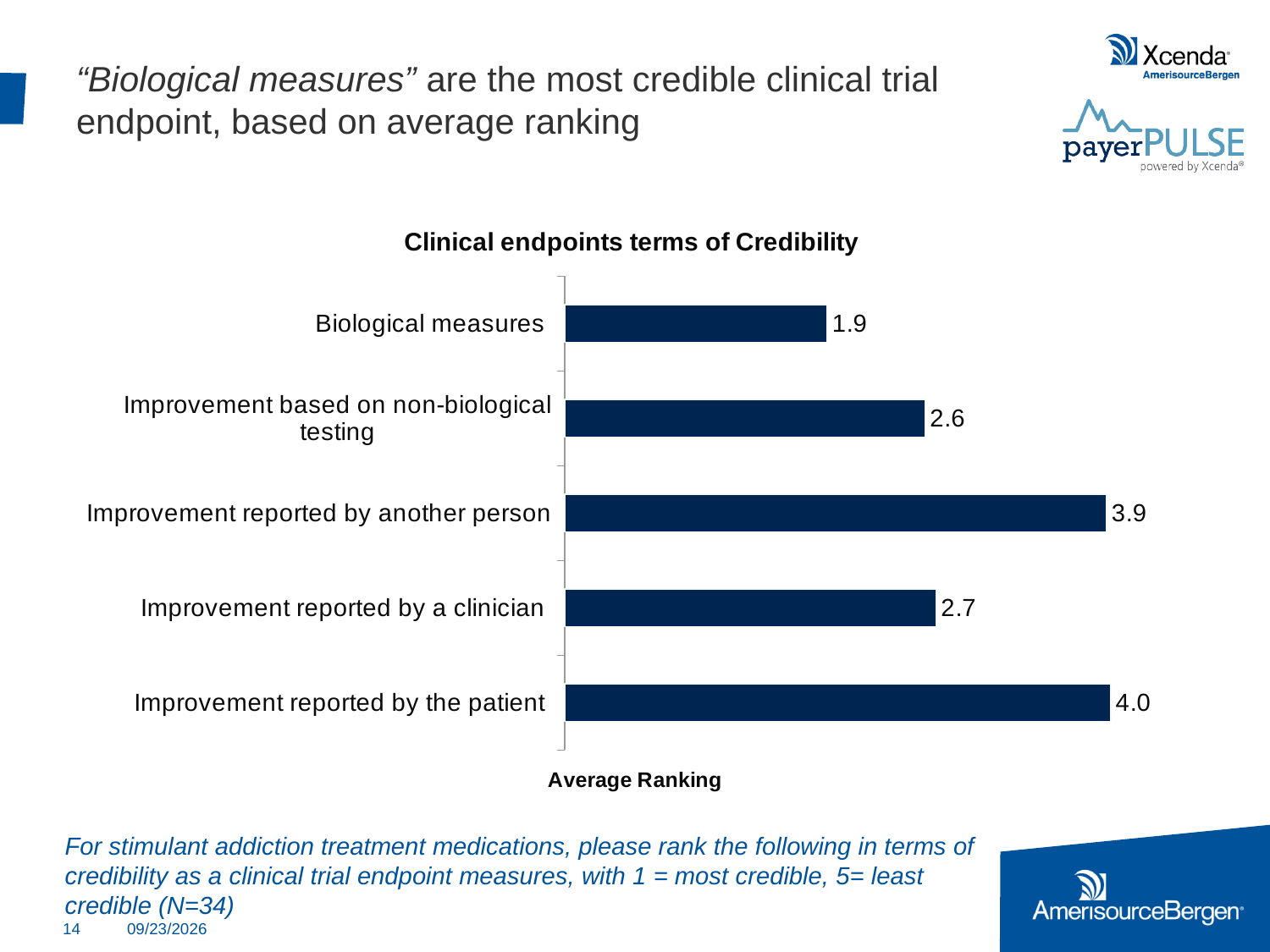
What is the difference between the average ranking for Improvement reported by another person and Improvement reported by a clinician? 1.2 What is the average ranking for Improvement reported by a clinician? 2.7 Which category has the highest average ranking? Improvement reported by the patient What is the average ranking for Improvement reported by the patient? 4.0 What kind of chart is shown on the slide? Bar chart Which has a higher average ranking, Improvement reported by another person or Improvement based on non-biological testing? Improvement reported by another person What is the title of the chart? Clinical endpoints terms of Credibility What is the average ranking for Improvement based on non-biological testing? 2.6 How many categories are shown in the chart? 5 Which category has the lowest average ranking? Biological measures What is the difference between the average ranking for Improvement reported by the patient and Biological measures? 2.1 What is the average ranking for Biological measures? 1.9